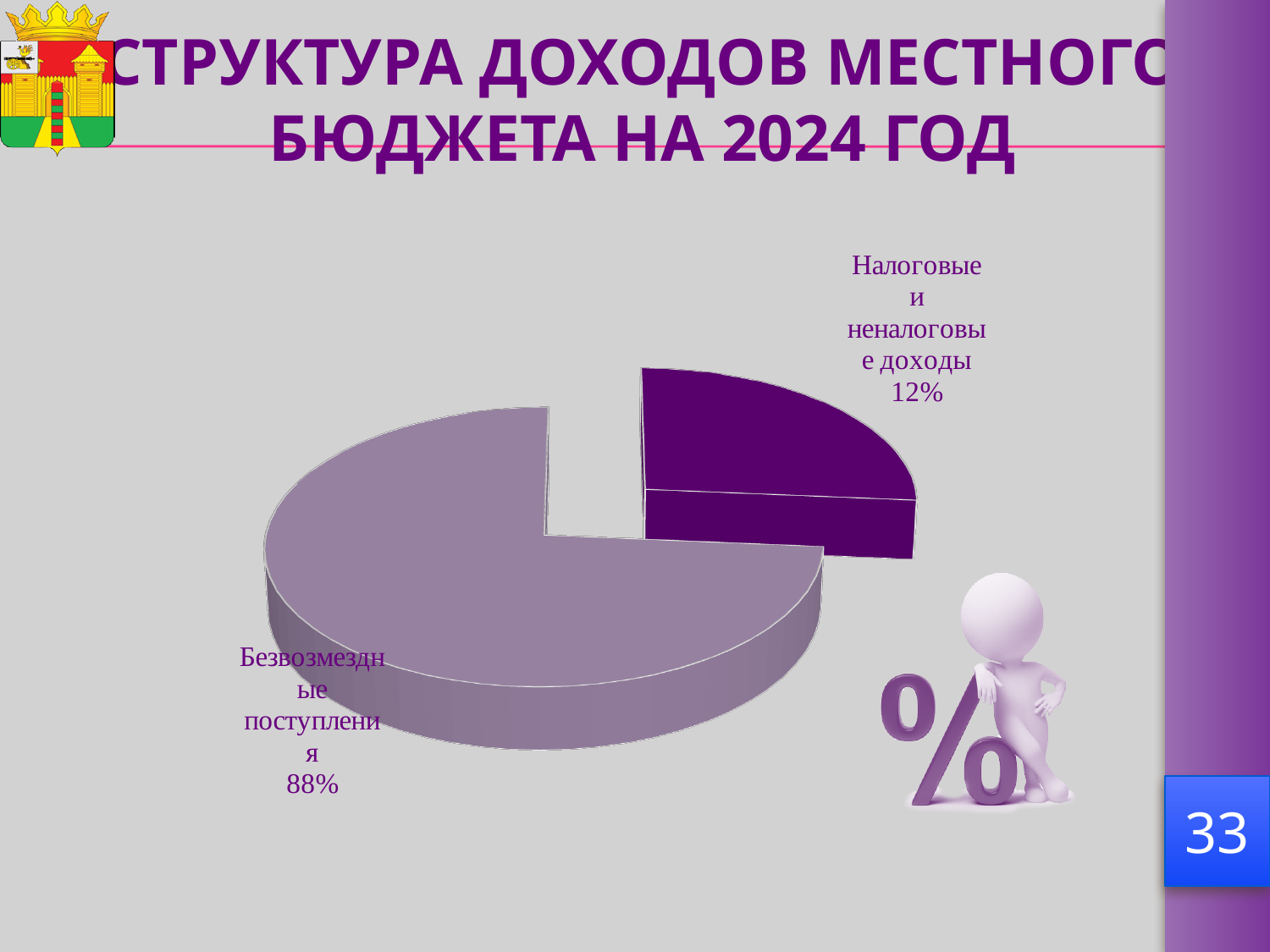
Which slice of the pie is the largest? Безвозмездные поступления How many slices does the pie chart have? 2 Which slice is pulled out (exploded) from the pie? Налоговые и неналоговые доходы What share of the pie does "Налоговые и неналоговые доходы" have? 12% Which is larger: "Налоговые и неналоговые доходы" or "Безвозмездные поступления"? Безвозмездные поступления What kind of chart is shown on the slide? Pie chart Which slice of the pie is the smallest? Налоговые и неналоговые доходы What is the difference in percentage points between "Безвозмездные поступления" and "Налоговые и неналоговые доходы"? 76 What share of the pie does "Безвозмездные поступления" have? 88% What is the title of the slide containing the pie chart? СТРУКТУРА ДОХОДОВ МЕСТНОГО БЮДЖЕТА НА 2024 ГОД